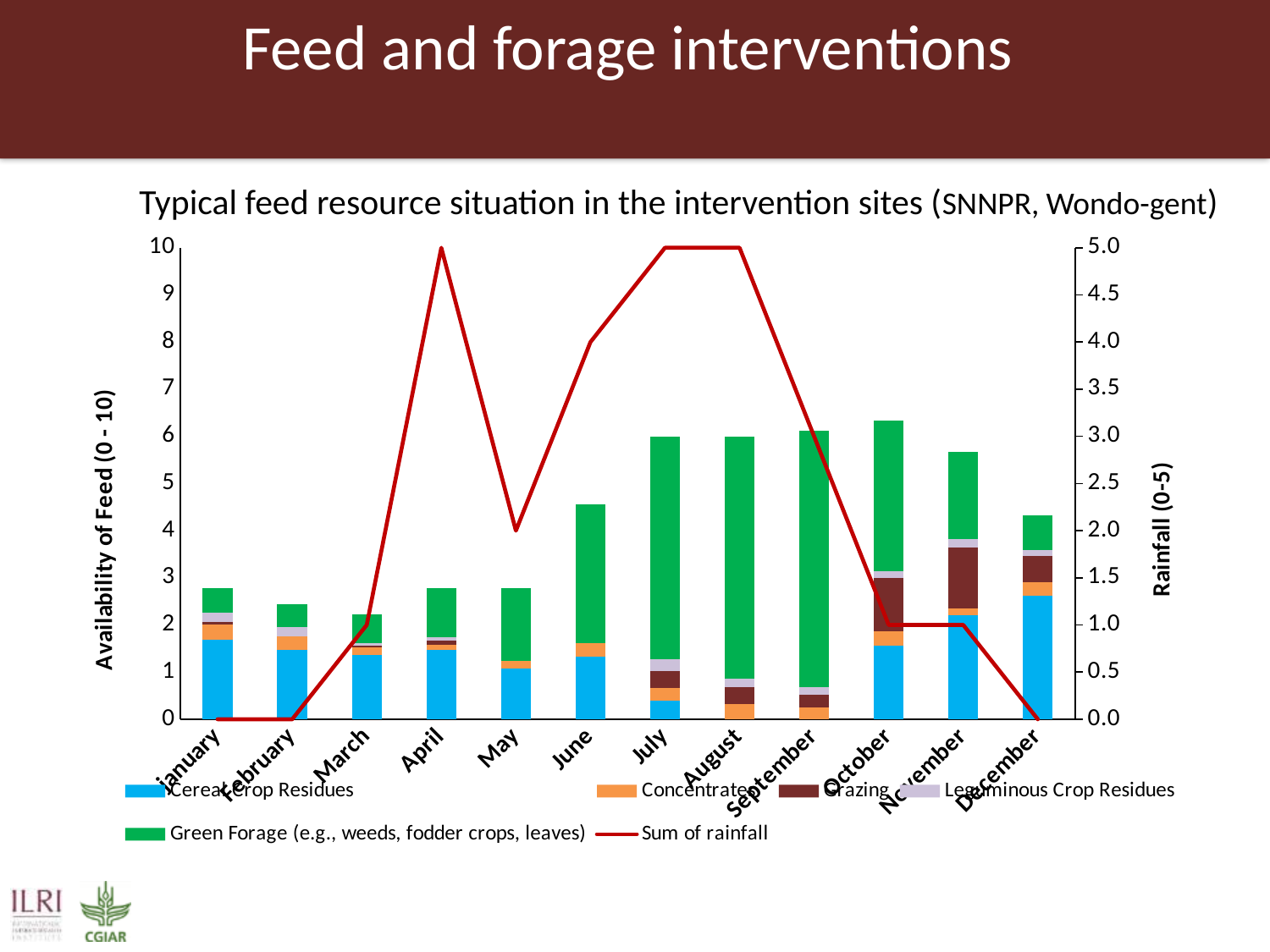
What kind of chart is shown on the slide? Stacked bar chart with a line What is the label of the right-hand vertical axis? Rainfall (0-5) How many series does the legend list? 6 What is the value of Sum of rainfall in April? 5.0 How many months are shown along the x axis? 12 Is the total availability of feed in October greater or less than 5? greater Is the total availability of feed in January greater or less than 4? less What is the value of Sum of rainfall in October? 1.0 What is the title of the chart? Typical feed resource situation in the intervention sites (SNNPR, Wondo-gent) What is the value of Sum of rainfall in January? 0.0 Does the Sum of rainfall rise or fall from August to December? Fall Which month has the higher Sum of rainfall, May or June? June